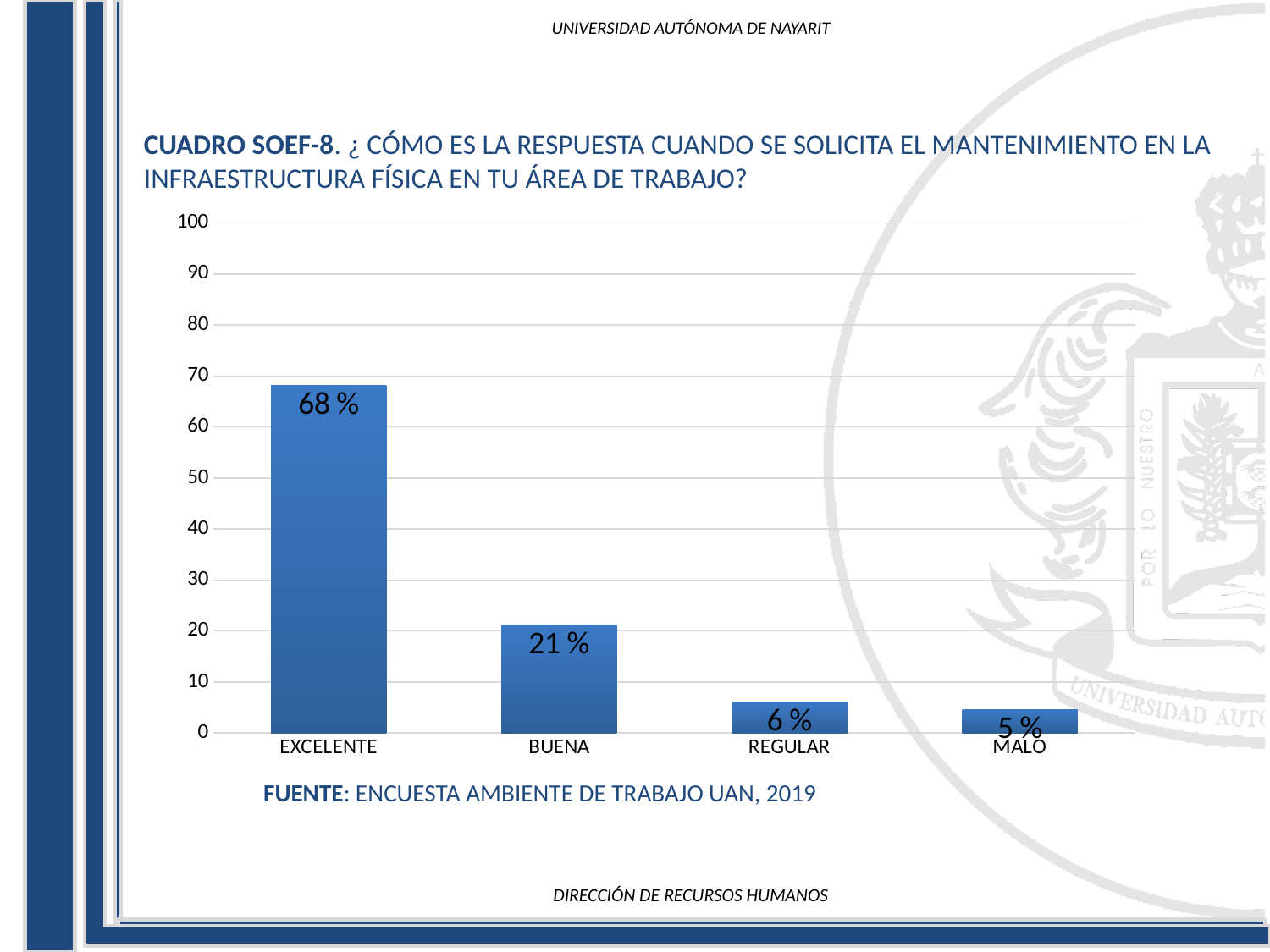
What is the difference between the values for BUENA and REGULAR? 15 % What is the difference between the values for EXCELENTE and BUENA? 47 % Which category has the highest value? EXCELENTE What is the value for MALO? 5 % What kind of chart is shown on the slide? bar chart How many categories are shown on the x axis? 4 What is the value for EXCELENTE? 68 % What is the value for REGULAR? 6 % What is the value for BUENA? 21 % Do the values rise or fall from left to right along the x axis? fall Which is larger, the value for BUENA or the value for REGULAR? BUENA Is the value for EXCELENTE greater or less than 60? greater